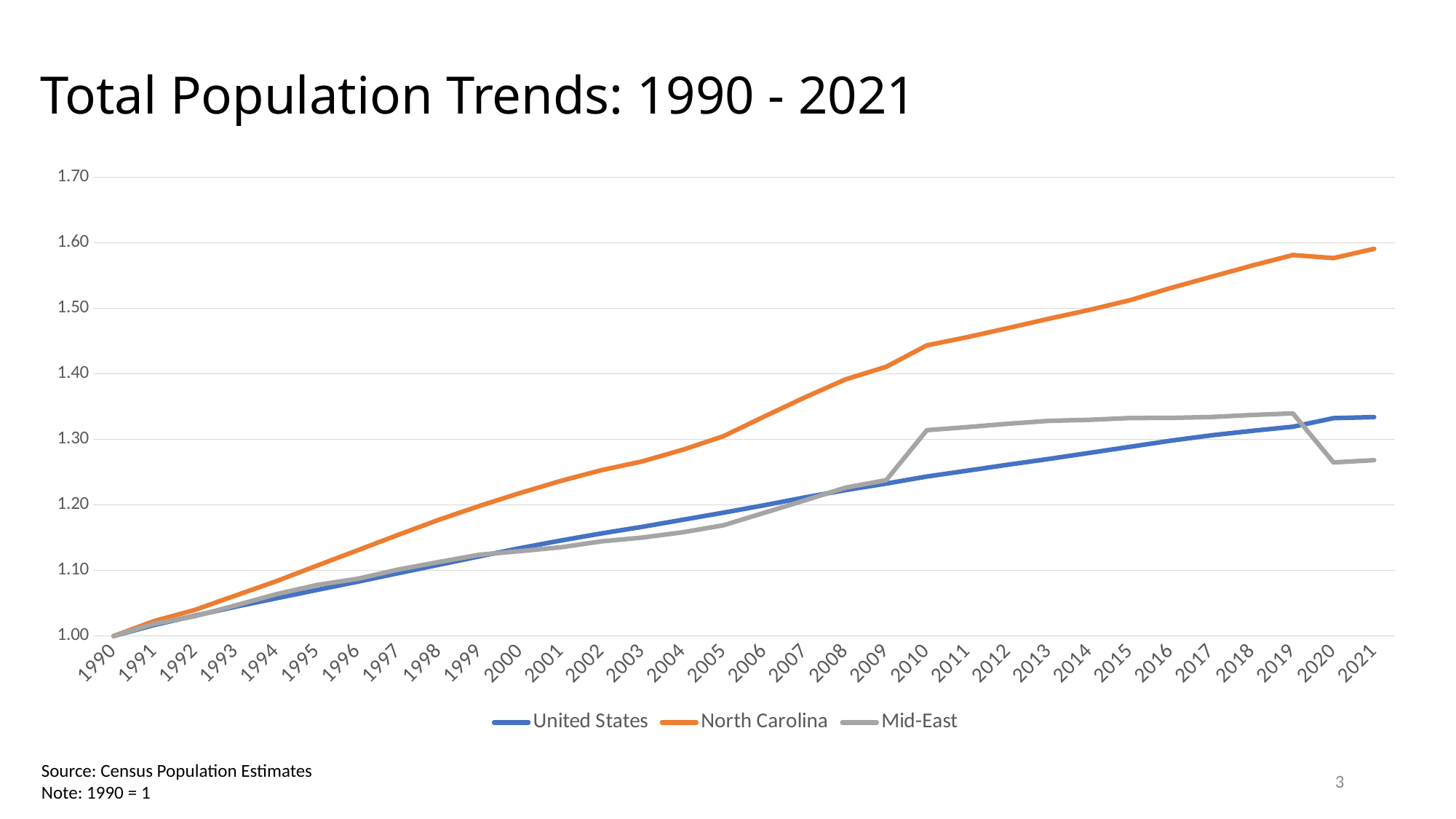
What kind of chart is shown on the slide? line chart Is the value for North Carolina in 2021 greater or less than 1.50? greater In 2015, which is larger: the value for United States or the value for Mid-East? Mid-East Which series has the highest value in 2021? North Carolina Is the value for North Carolina in 2010 greater or less than 1.40? greater Does the North Carolina line rise or fall from 1990 to 2021? rise Is the value for United States in 2021 greater or less than 1.40? less Which series has the lowest value in 2021? Mid-East How many series does the legend list? 3 How many years are plotted along the x axis? 32 What is the value for North Carolina in 1990? 1.00